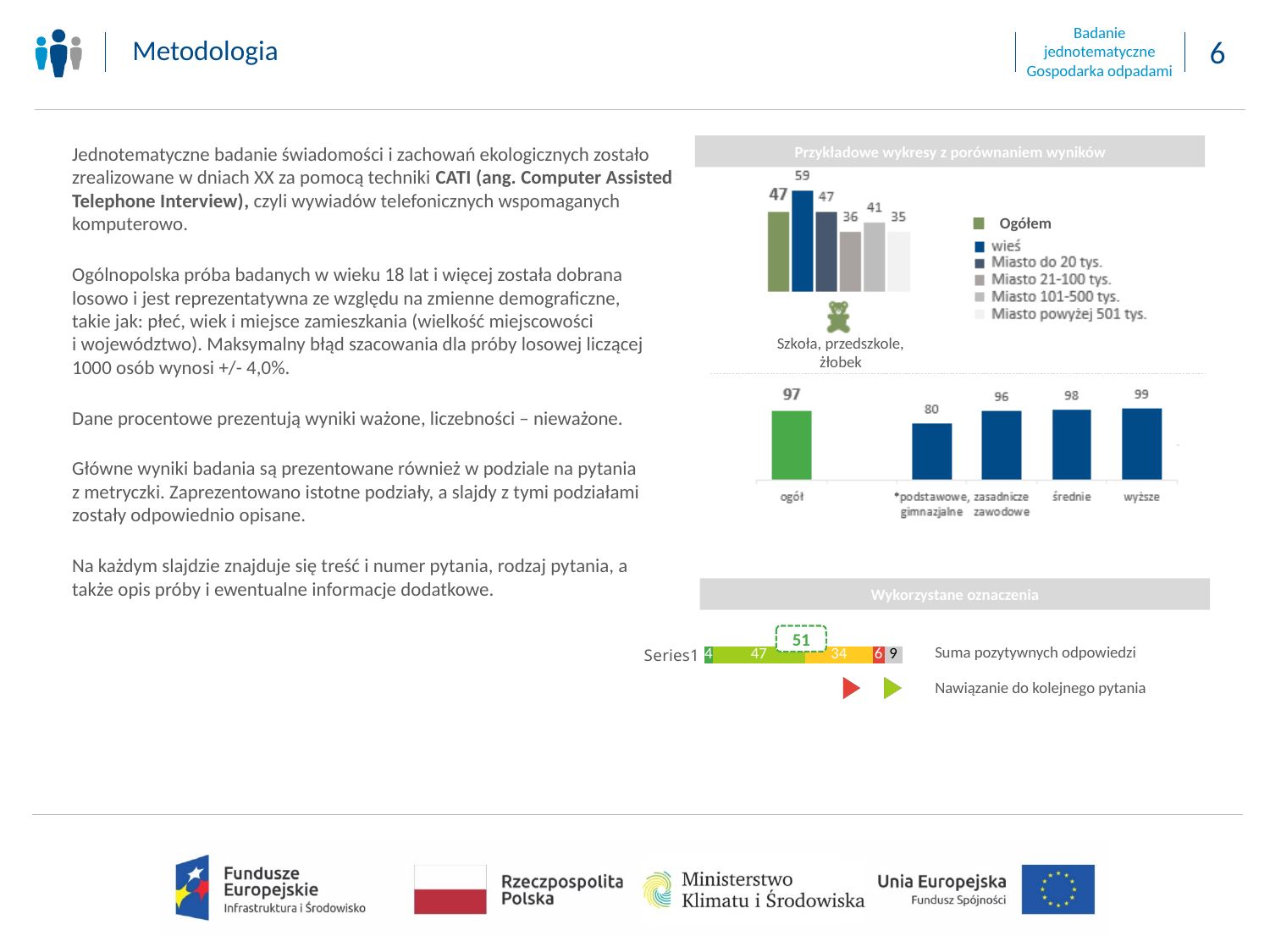
In the middle chart on the right, what is the difference between the values for 'średnie' and '*podstawowe, gimnazjalne'? 18 In the middle chart on the right, what is the value for 'wyższe'? 99 In the top-right chart labelled 'Szkoła, przedszkole, żłobek', which category has the lowest value? Miasto powyżej 501 tys. In the top-right chart labelled 'Szkoła, przedszkole, żłobek', how many entries does the legend list? 6 In the middle chart on the right, which category has the lowest value? *podstawowe, gimnazjalne In the top-right chart labelled 'Szkoła, przedszkole, żłobek', what is the value for 'wieś'? 59 In the bottom stacked bar chart under 'Wykorzystane oznaczenia', what is the largest segment value shown for Series1? 47 In the middle chart on the right (with categories ogół, podstawowe, zasadnicze zawodowe, średnie, wyższe), what is the value for 'ogół'? 97 In the middle chart on the right, what kind of chart is shown? bar chart In the top-right chart labelled 'Szkoła, przedszkole, żłobek', what is the value for 'Ogółem'? 47 In the top-right chart labelled 'Szkoła, przedszkole, żłobek', which category has the highest value? wieś In the top-right chart labelled 'Szkoła, przedszkole, żłobek', what is the difference between the values for 'wieś' and 'Miasto 21-100 tys.'? 23